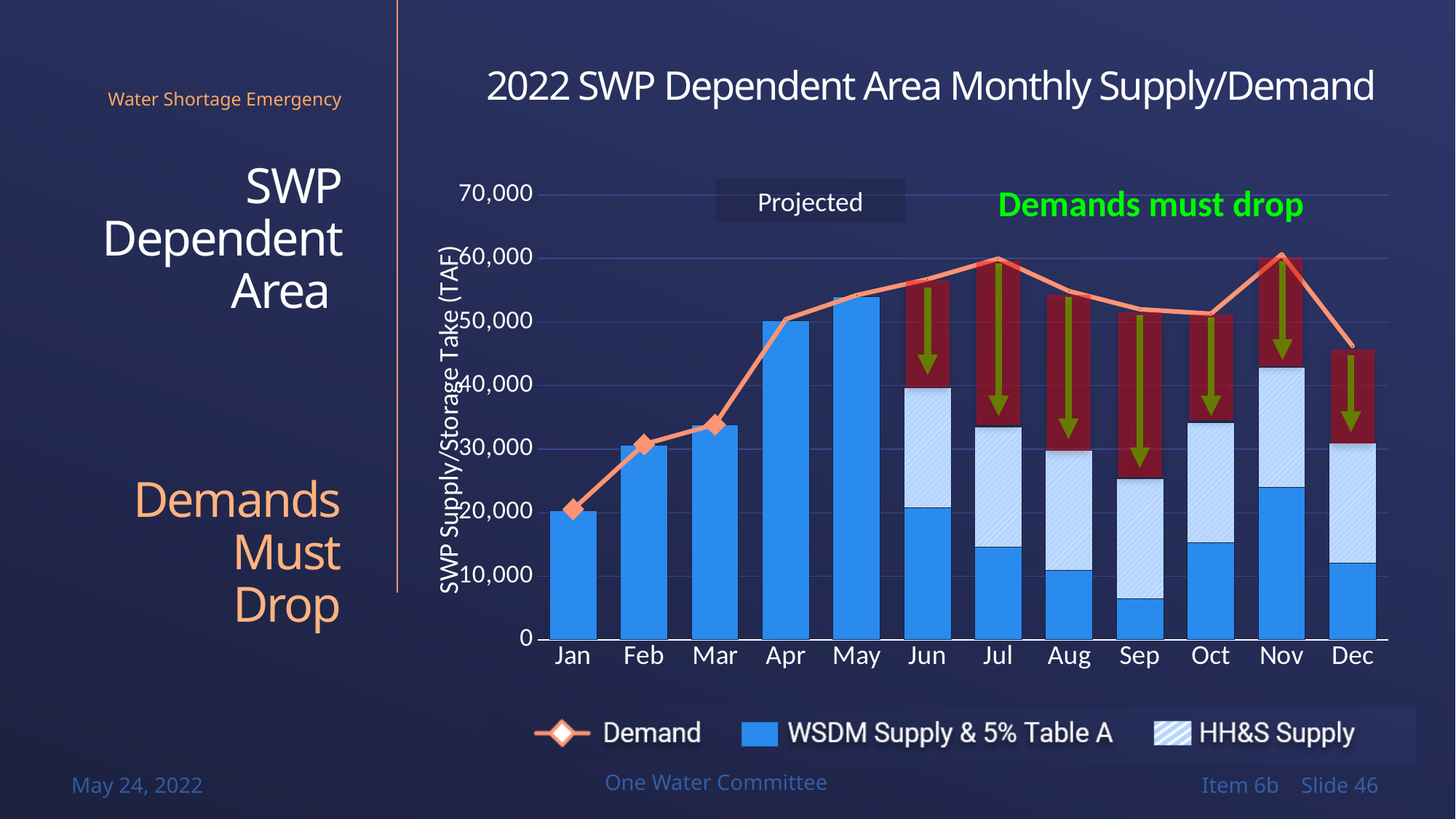
What kind of chart is shown on the slide? Stacked bar chart with a line series How many months are shown on the x axis of the chart? 12 Does the Demand line rise or fall from Jan to Jul? rise Is the WSDM Supply & 5% Table A value for Sep greater or less than 10,000? less Which month has the lowest WSDM Supply & 5% Table A value? Sep Is the WSDM Supply & 5% Table A value for May greater or less than 50,000? greater Which is larger, the Demand value for Jun or the Demand value for Dec? Jun How many series does the chart legend list? 3 Is the Demand value for Dec greater or less than 50,000? less Which month has the highest WSDM Supply & 5% Table A value? May What is the title of the chart? 2022 SWP Dependent Area Monthly Supply/Demand Which series is drawn as a line with diamond markers? Demand